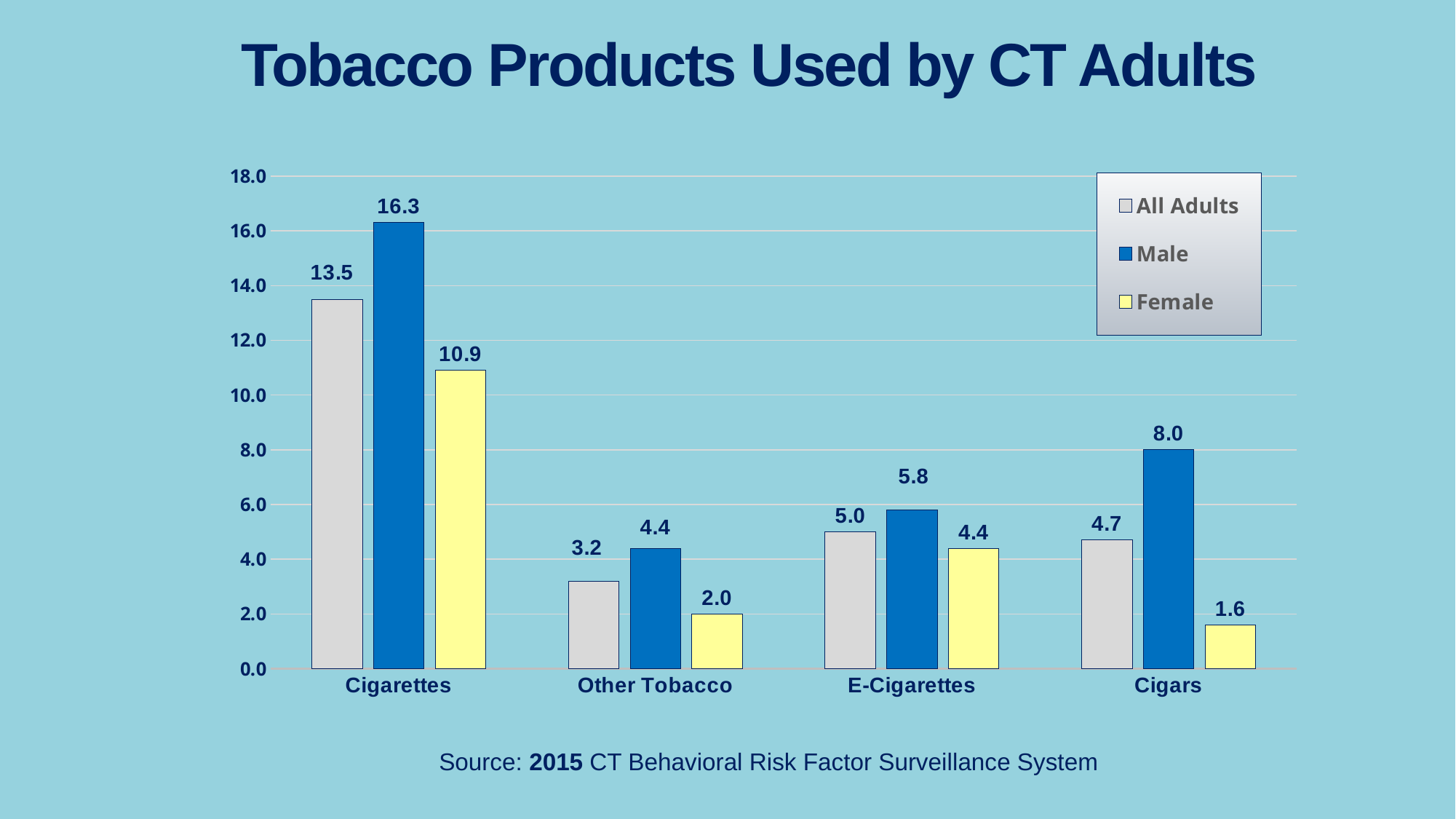
How many product categories are shown on the x axis? 4 What is the difference between the Male and Female values for Cigars? 6.4 What kind of chart is shown on the slide? Bar chart What is the value for All Adults in the E-Cigarettes category? 5.0 Which category has the lowest Female value? Cigars Is the Female value for Cigarettes greater or less than 10.0? greater How many series does the legend list? 3 What is the value for Female in the Other Tobacco category? 2.0 Which category has the highest Male value? Cigarettes What is the title of the chart? Tobacco Products Used by CT Adults What is the value for Male in the Cigarettes category? 16.3 Which is larger: the All Adults value for E-Cigarettes or the All Adults value for Cigars? E-Cigarettes